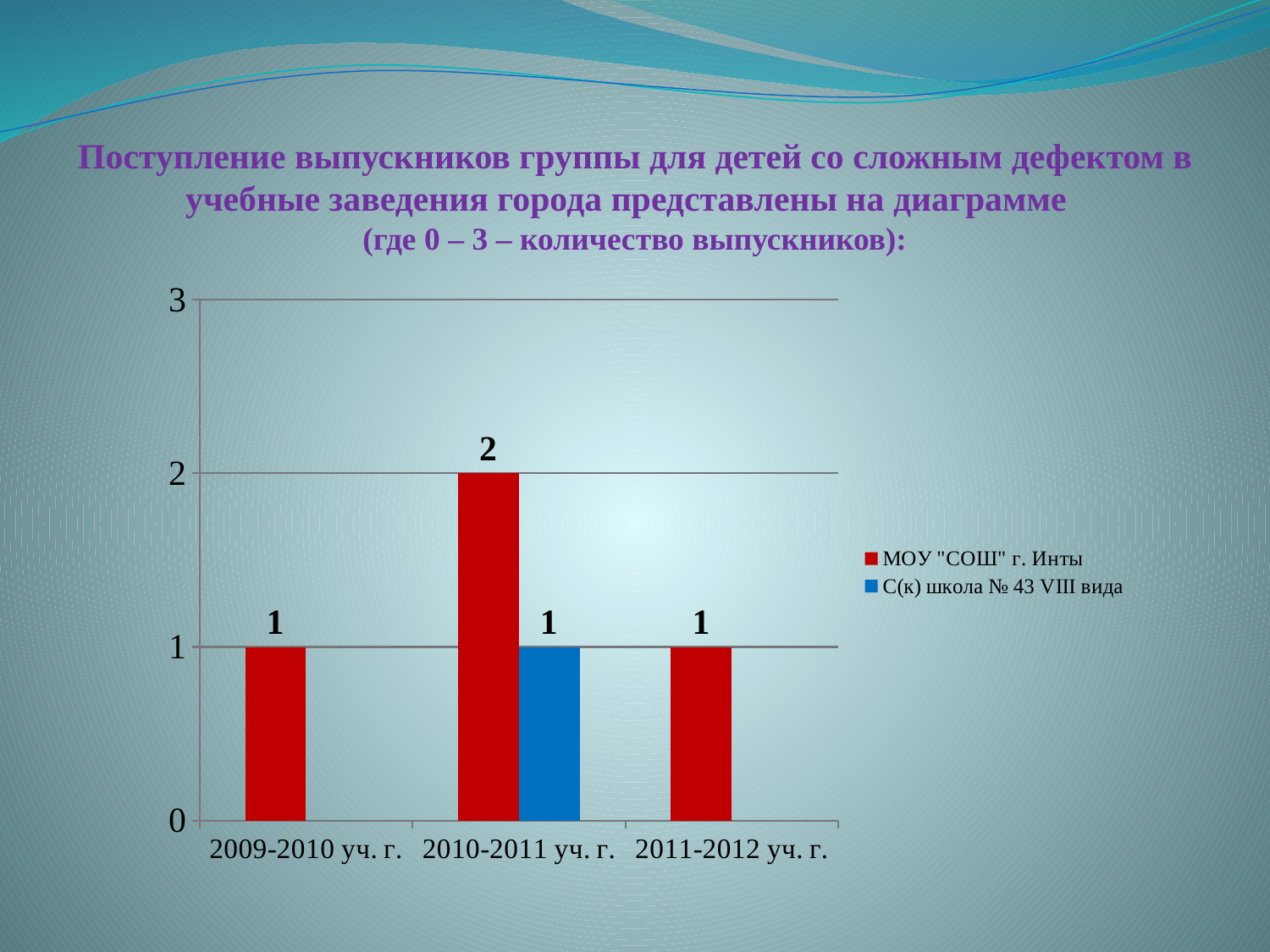
What is the value for МОУ "СОШ" г. Инты in 2011-2012 уч. г.? 1 What is the difference between the МОУ "СОШ" г. Инты value and the С(к) школа № 43 VIII вида value in 2010-2011 уч. г.? 1 In 2010-2011 уч. г., which series has the larger value: МОУ "СОШ" г. Инты or С(к) школа № 43 VIII вида? МОУ "СОШ" г. Инты How many academic years are shown on the x axis? 3 In which academic year does С(к) школа № 43 VIII вида have a bar? 2010-2011 уч. г. In which academic year is the value for МОУ "СОШ" г. Инты highest? 2010-2011 уч. г. Which colour represents С(к) школа № 43 VIII вида in the legend? Blue What is the value for С(к) школа № 43 VIII вида in 2010-2011 уч. г.? 1 What is the value for МОУ "СОШ" г. Инты in 2010-2011 уч. г.? 2 What is the value for МОУ "СОШ" г. Инты in 2009-2010 уч. г.? 1 What kind of chart is shown on the slide? Bar chart How many series does the legend list? 2